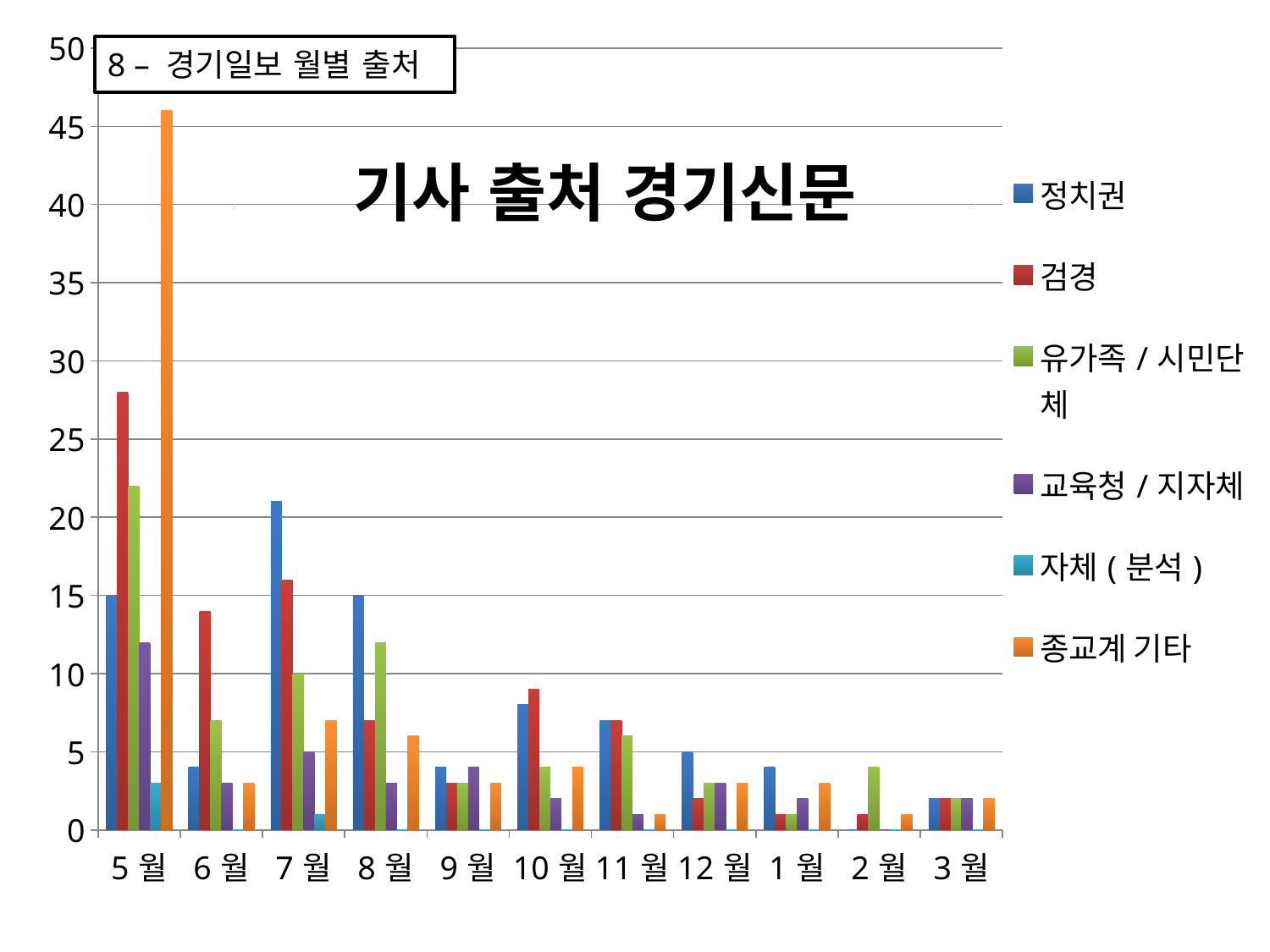
Is the value for 종교계 기타 in 5 월 greater or less than 40? greater How many series does the legend list? 6 Which series has the tallest bar in 7 월? 정치권 Which series has the tallest bar in 5 월? 종교계 기타 Do the 종교계 기타 values rise or fall from 5 월 to 6 월? fall In which month is the 정치권 bar the highest? 7 월 Is the value for 검경 in 6 월 greater or less than 10? greater In 5 월, which is larger: the 검경 bar or the 정치권 bar? 검경 What is the title of the chart? 기사 출처 경기신문 How many months are shown on the x axis? 11 What kind of chart is shown on the slide? bar chart Is the value for 검경 in 5 월 greater or less than 25? greater